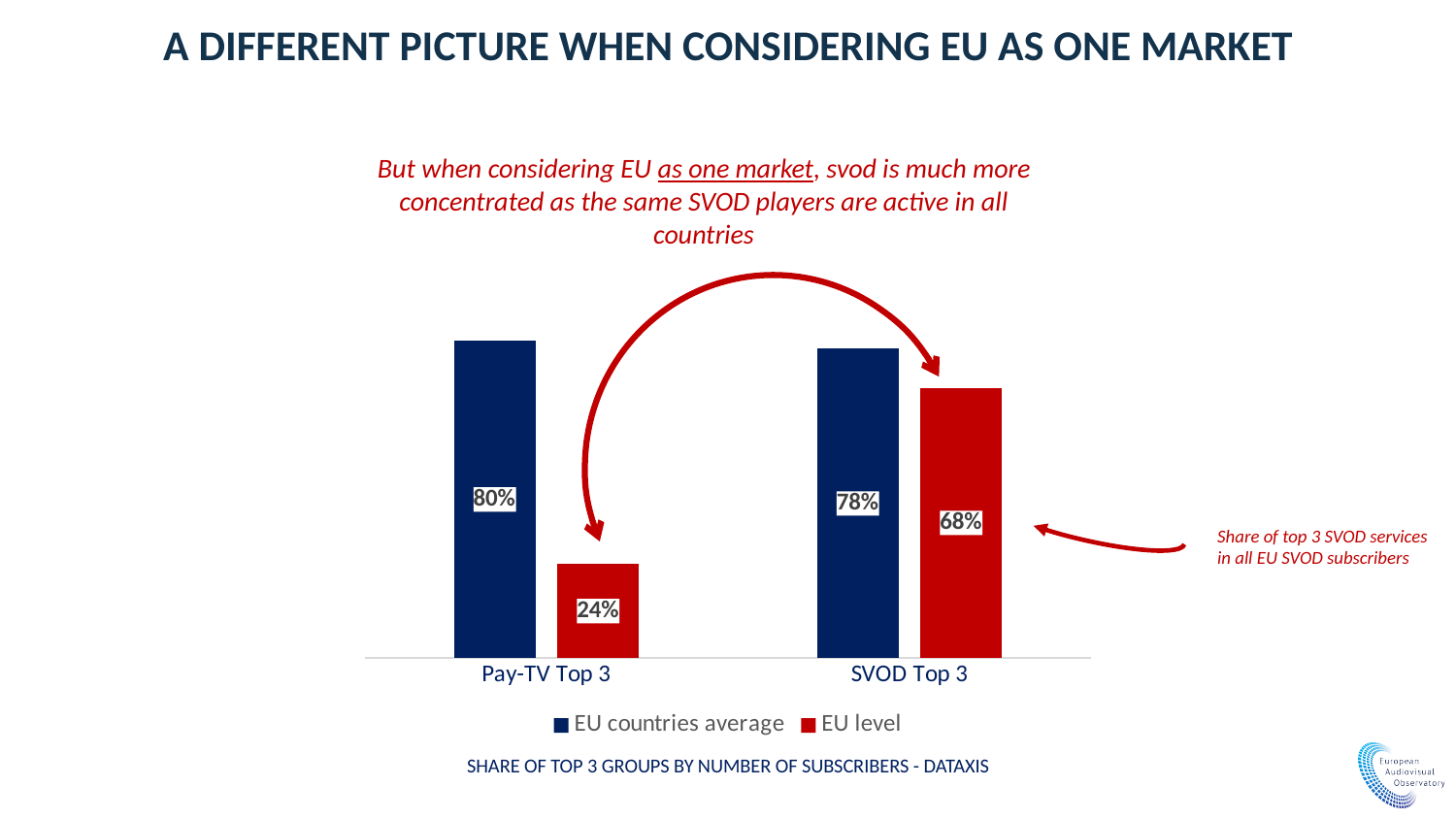
Which is larger: the EU level value for SVOD Top 3 or the EU level value for Pay-TV Top 3? SVOD Top 3 Which category has the lowest EU level value? Pay-TV Top 3 How many series does the legend list? 2 How many categories are shown on the x axis? 2 What is the EU countries average value for Pay-TV Top 3? 80% What is the difference between the EU countries average and EU level values for SVOD Top 3? 10% What is the EU level value for Pay-TV Top 3? 24% What is the EU level value for SVOD Top 3? 68% What is the EU countries average value for SVOD Top 3? 78% Which colour represents the EU level series in the legend? Red What is the difference between the EU countries average and EU level values for Pay-TV Top 3? 56% What kind of chart is shown on the slide? Bar chart